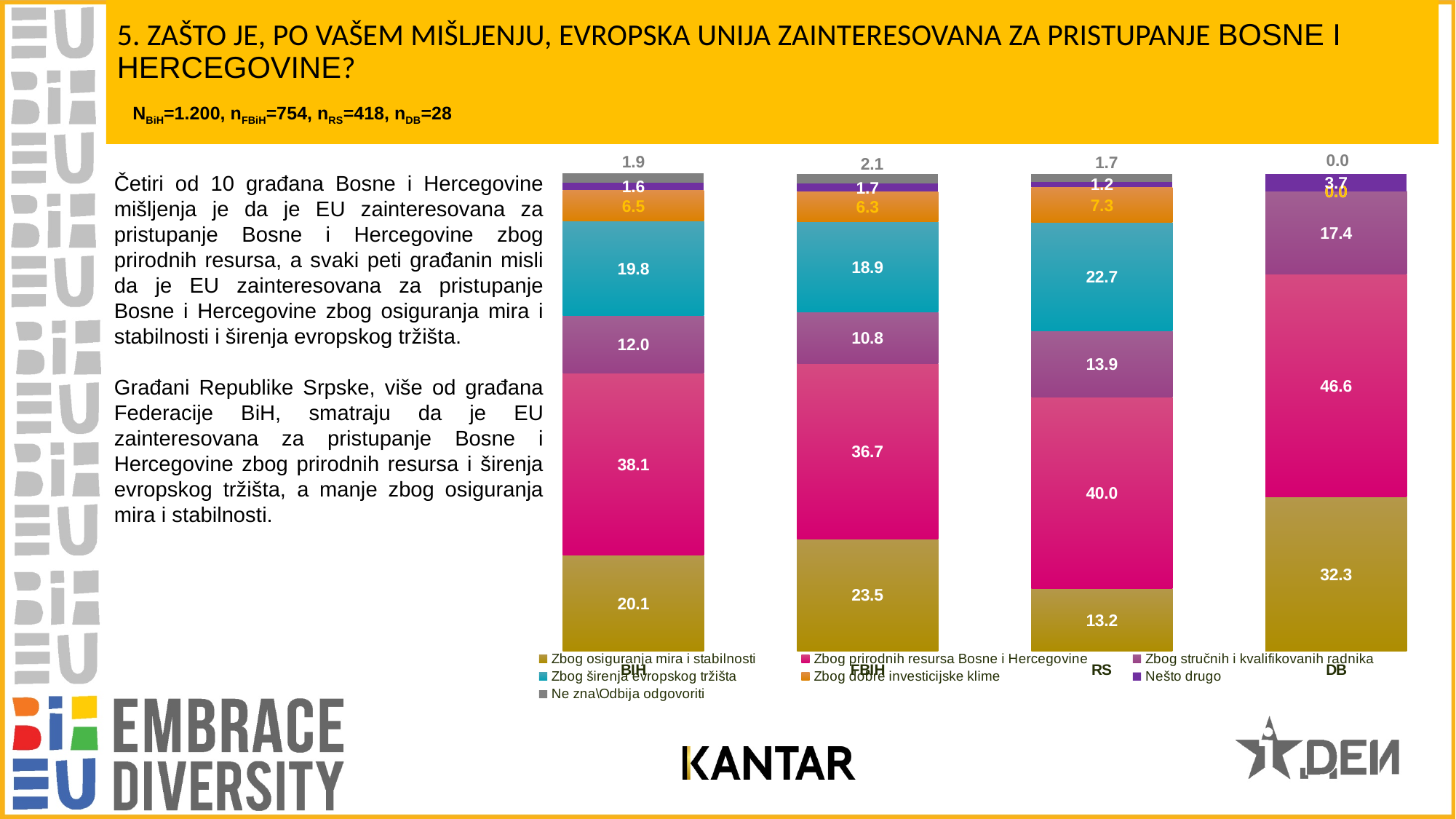
What is the difference between the 'Zbog prirodnih resursa Bosne i Hercegovine' values for RS and FBIH? 3.3 How many series does the chart legend list? 7 What is the value of 'Zbog osiguranja mira i stabilnosti' for FBIH? 23.5 Which is larger: the 'Zbog širenja evropskog tržišta' value for RS or for FBIH? RS Which category has the lowest value for 'Zbog osiguranja mira i stabilnosti'? RS What is the value of 'Nešto drugo' for DB? 3.7 What kind of chart is shown on the slide? stacked bar chart What is the value of 'Zbog prirodnih resursa Bosne i Hercegovine' for RS? 40.0 What is the value of 'Zbog širenja evropskog tržišta' for BIH? 19.8 What is the value of 'Zbog stručnih i kvalifikovanih radnika' for DB? 17.4 How many categories (bars) are shown on the x axis of the chart? 4 Which category has the highest value for 'Zbog prirodnih resursa Bosne i Hercegovine'? DB